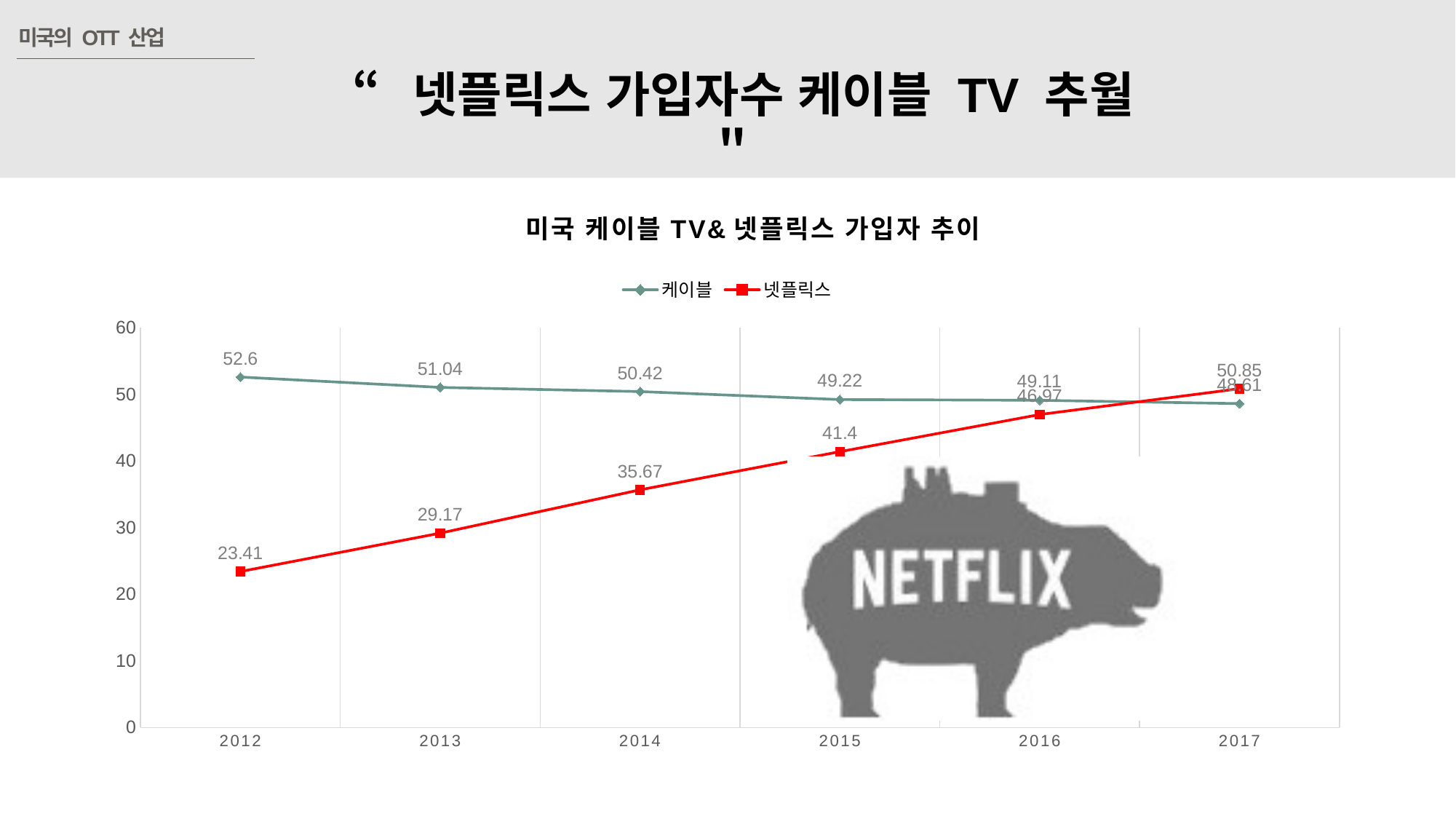
What is the value for 넷플릭스 in 2015? 41.4 Does the 넷플릭스 series rise or fall from 2012 to 2017? rise What is the title of the chart? 미국 케이블 TV& 넷플릭스 가입자 추이 In which year is the 넷플릭스 value lowest? 2012 What type of chart is shown on the slide? line chart Which series has the larger value in 2017, 케이블 or 넷플릭스? 넷플릭스 What is the value for 넷플릭스 in 2012? 23.41 How many series does the legend list? 2 In which year is the 케이블 value highest? 2012 How many years are plotted on the x axis? 6 What is the difference between the 케이블 and 넷플릭스 values in 2013? 21.87 What is the value for 케이블 in 2014? 50.42